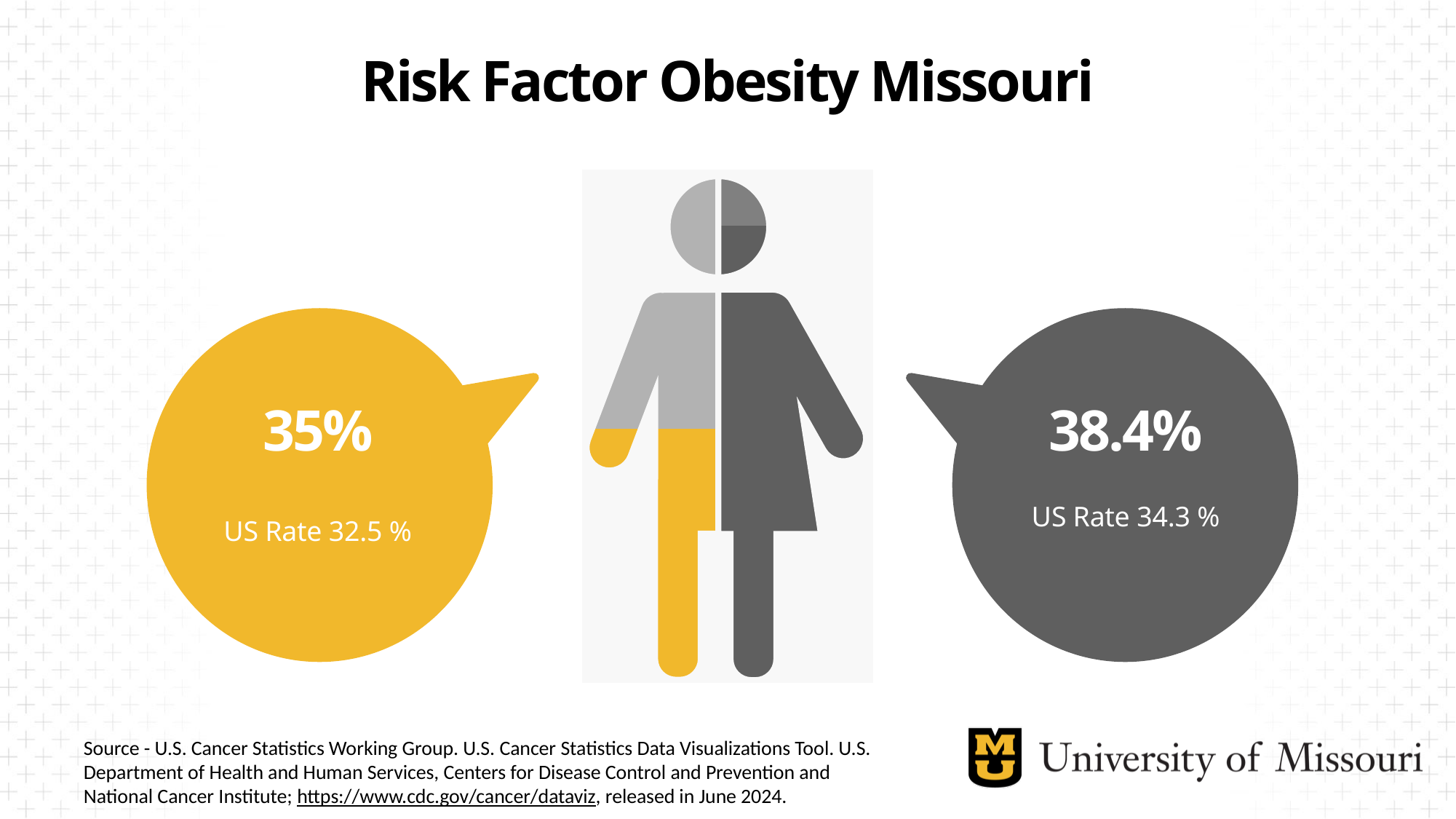
Is the Missouri value in the yellow callout (35%) greater or less than its US rate of 32.5 %? greater By how many percentage points does the yellow callout's 35% exceed its US rate of 32.5 %? 2.5 percentage points Which callout shows the higher Missouri percentage, the yellow one on the left or the gray one on the right? the gray one on the right What percentage is shown in the yellow callout on the left? 35% What is the title of the slide's infographic? Risk Factor Obesity Missouri What is the difference between the two Missouri percentages shown, 38.4% and 35%? 3.4 percentage points By how many percentage points does the gray callout's 38.4% exceed its US rate of 34.3 %? 4.1 percentage points How many percentage callouts are shown on the slide? 2 What percentage is shown in the gray callout on the right? 38.4% Is the Missouri value in the gray callout (38.4%) greater or less than its US rate of 34.3 %? greater What US rate is printed in the gray callout on the right? 34.3 % What US rate is printed in the yellow callout on the left? 32.5 %